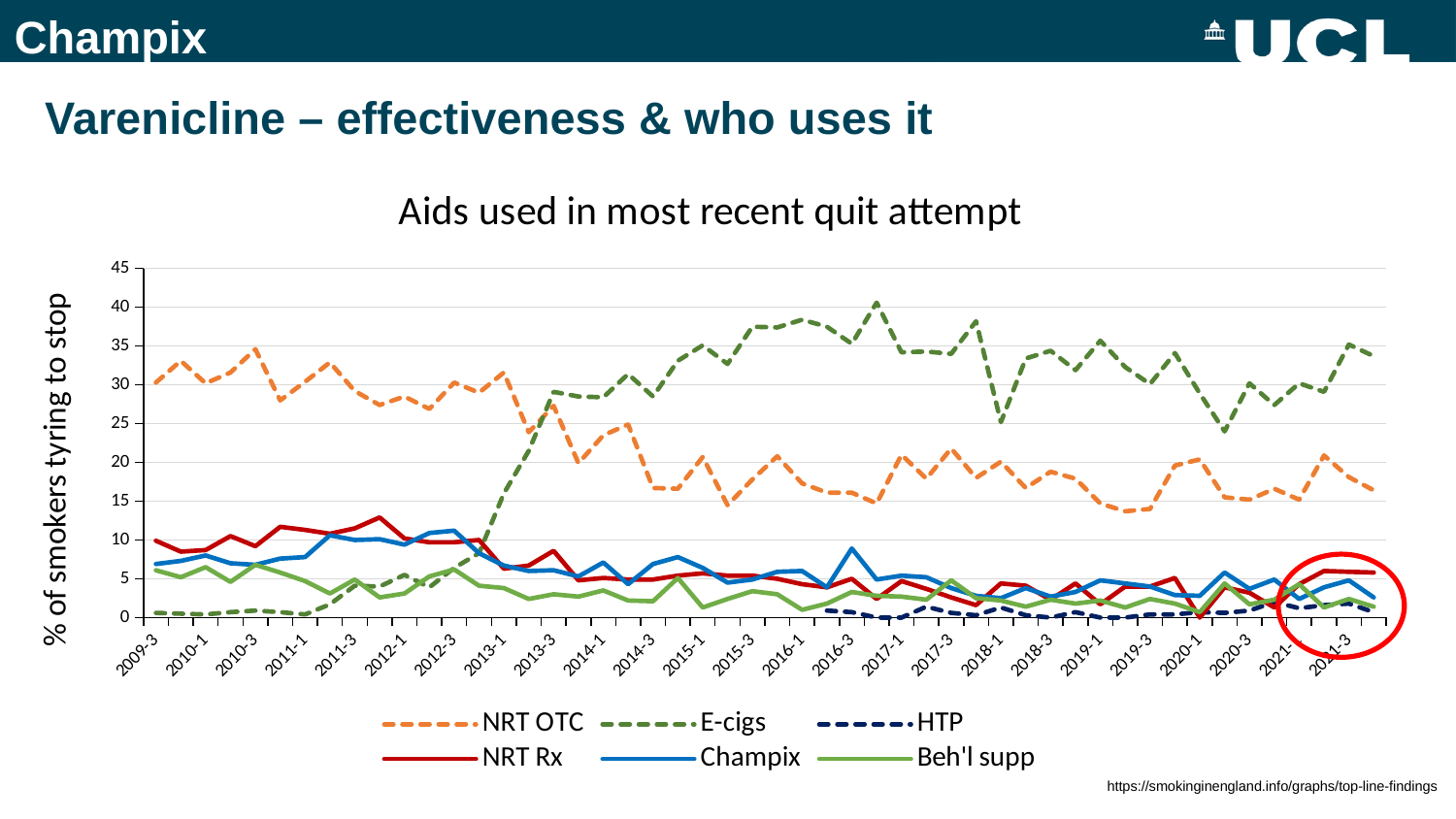
What kind of chart is shown on the slide? line chart Is the value for Champix at 2021-3 greater or less than 10? less At 2014-3, which is larger: E-cigs or NRT OTC? E-cigs What is the title of the chart? Aids used in most recent quit attempt What is the label on the vertical axis of the chart? % of smokers tyring to stop How many series does the legend of the chart list? 6 Is the value for E-cigs at 2009-3 greater or less than 5? less Which series has the highest value at 2021-3? E-cigs At 2009-3, which is larger: NRT OTC or E-cigs? NRT OTC Does the NRT OTC series generally rise or fall from 2009-3 to 2021-3? fall Is the value for NRT OTC at 2009-3 greater or less than 25? greater